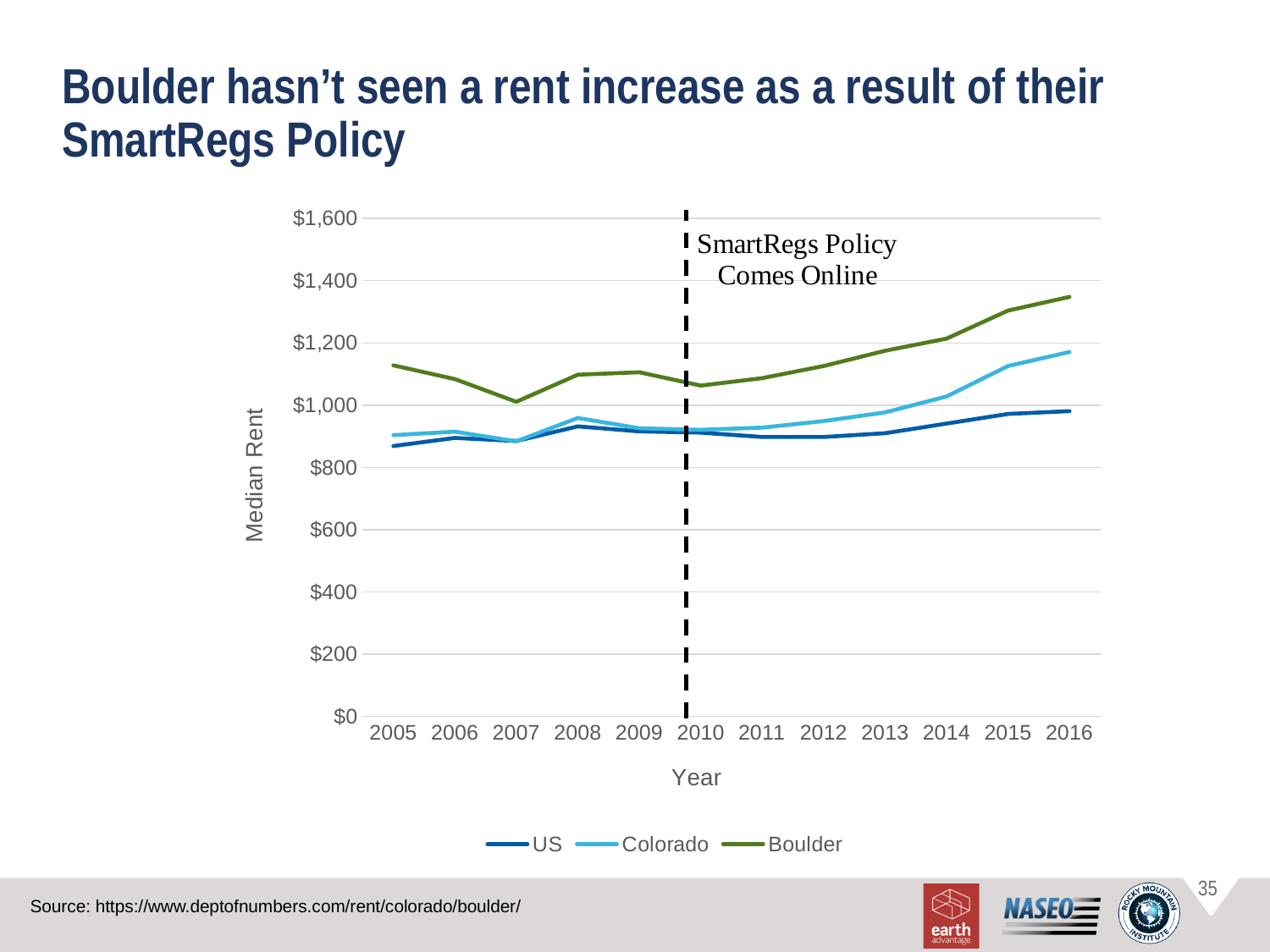
How many years are plotted along the x axis? 12 Is the US median rent in 2005 greater or less than $1,000? less Does the Boulder median rent rise or fall from 2010 to 2016? Rise Which series has the highest median rent in 2016? Boulder Which series has the lowest median rent in 2016? US Is the Boulder median rent in 2016 greater or less than $1,200? greater What event does the dashed vertical line on the chart mark? SmartRegs Policy Comes Online Which is larger in 2014, the Colorado median rent or the US median rent? Colorado Is the Colorado median rent in 2016 greater or less than $1,000? greater What kind of chart is shown on the slide? Line chart How many series does the legend list? 3 In which year is the Boulder median rent at its lowest? 2007